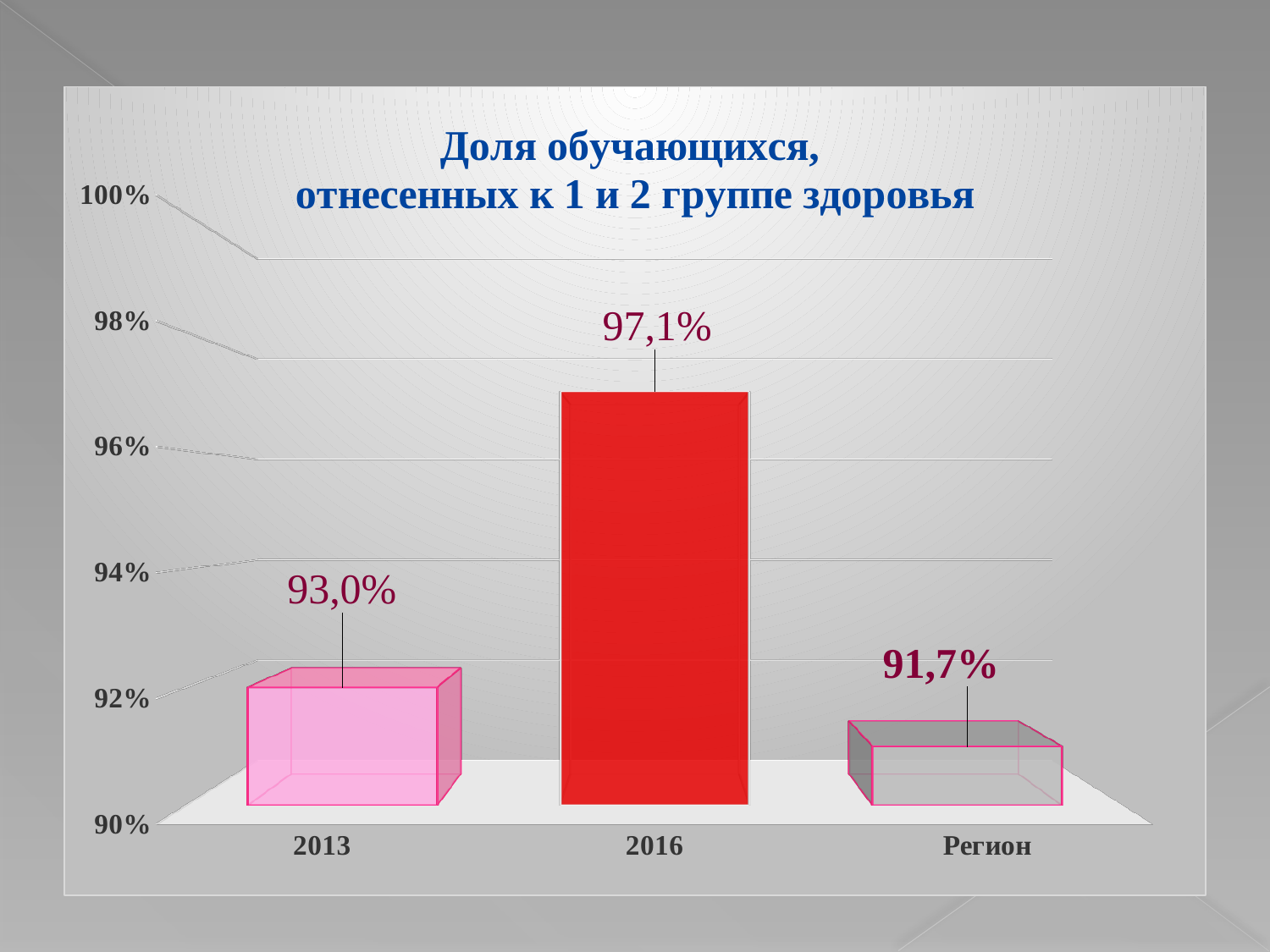
What is the value for 2016? 97,1% Is the value for 2016 greater or less than 96%? greater Which is larger, the value for 2013 or the value for Регион? 2013 What is the value for Регион? 91,7% What kind of chart is shown on the slide? bar chart What is the difference between the values for 2013 and Регион? 1,3% What is the title of the chart? Доля обучающихся, отнесенных к 1 и 2 группе здоровья How many categories are shown on the x axis? 3 What is the difference between the values for 2016 and 2013? 4,1% Which category has the lowest value? Регион What is the value for 2013? 93,0% Which category has the highest value? 2016